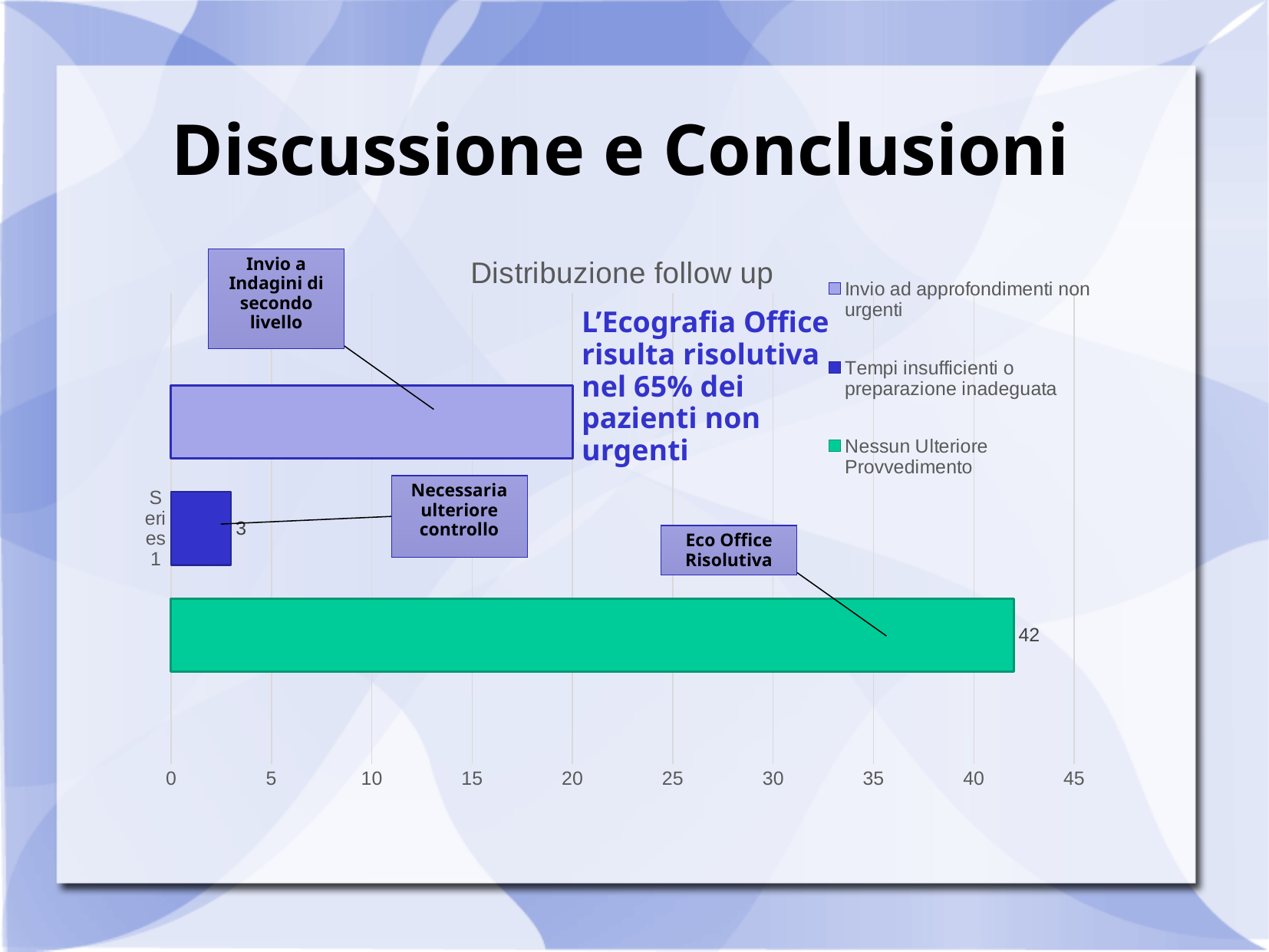
Is the value for Invio ad approfondimenti non urgenti greater or less than 25? less What is the value for Tempi insufficienti o preparazione inadeguata? 3 Is the value for Invio ad approfondimenti non urgenti greater or less than 15? greater What is the title of the chart? Distribuzione follow up Which series has the lowest value? Tempi insufficienti o preparazione inadeguata Which is larger: the value for Nessun Ulteriore Provvedimento or the value for Invio ad approfondimenti non urgenti? Nessun Ulteriore Provvedimento What kind of chart is shown on the slide? bar chart What colour is the bar for Nessun Ulteriore Provvedimento? green What is the difference between the values for Nessun Ulteriore Provvedimento and Tempi insufficienti o preparazione inadeguata? 39 What is the value for Nessun Ulteriore Provvedimento? 42 How many series does the legend of the chart list? 3 Which series has the highest value? Nessun Ulteriore Provvedimento